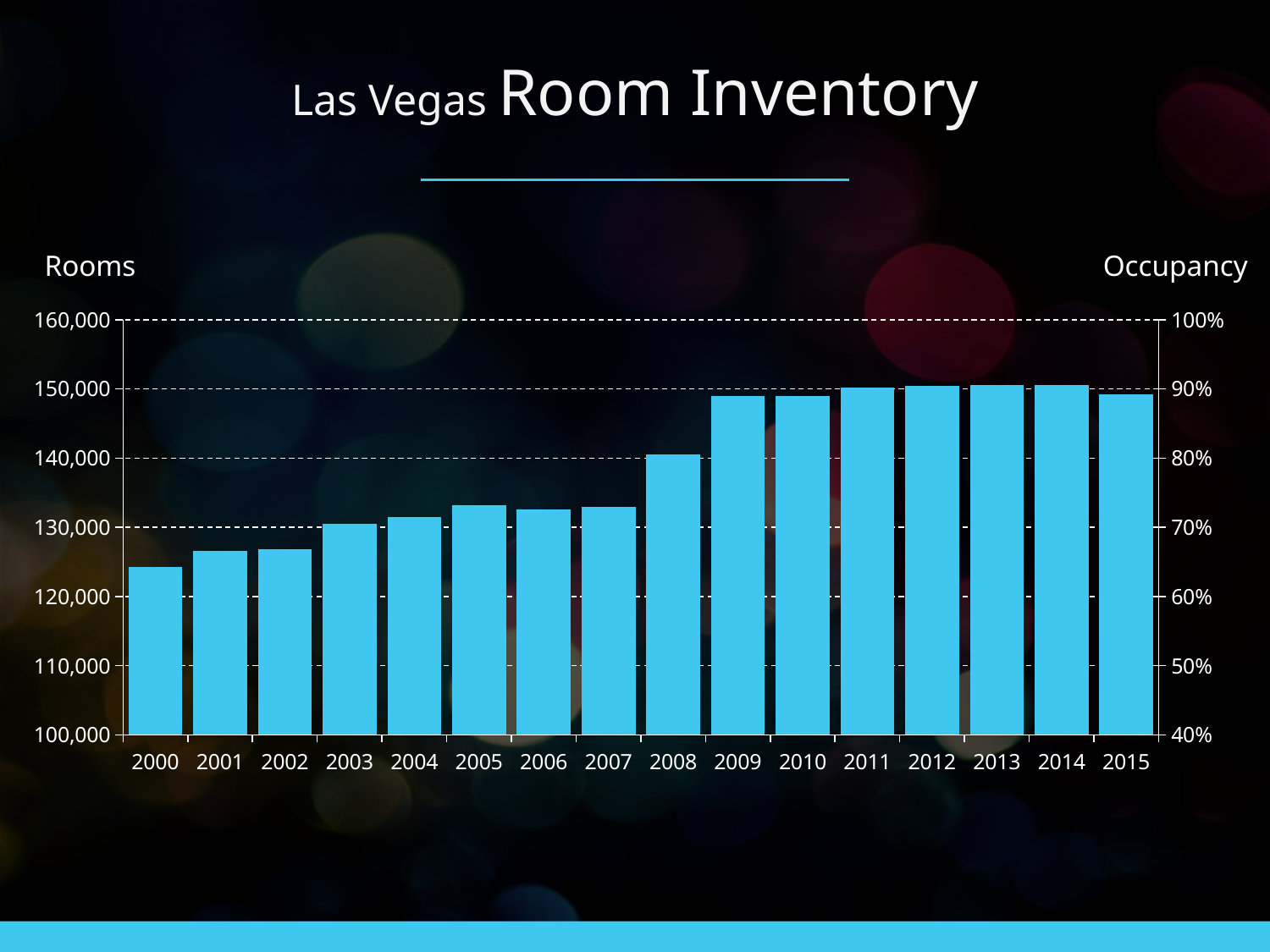
Is the value for 2012 greater or less than 140,000? greater Is the value for 2005 greater or less than 130,000? greater Do the room values generally rise or fall from 2000 to 2015? rise Which year has the lowest number of rooms? 2000 How many years are shown on the x axis of the chart? 16 Which year has more rooms, 2007 or 2008? 2008 Which year has more rooms, 2000 or 2009? 2009 Is the value for 2001 greater or less than 120,000? greater What is the title of the chart on the slide? Las Vegas Room Inventory What kind of chart is shown on the slide? bar chart